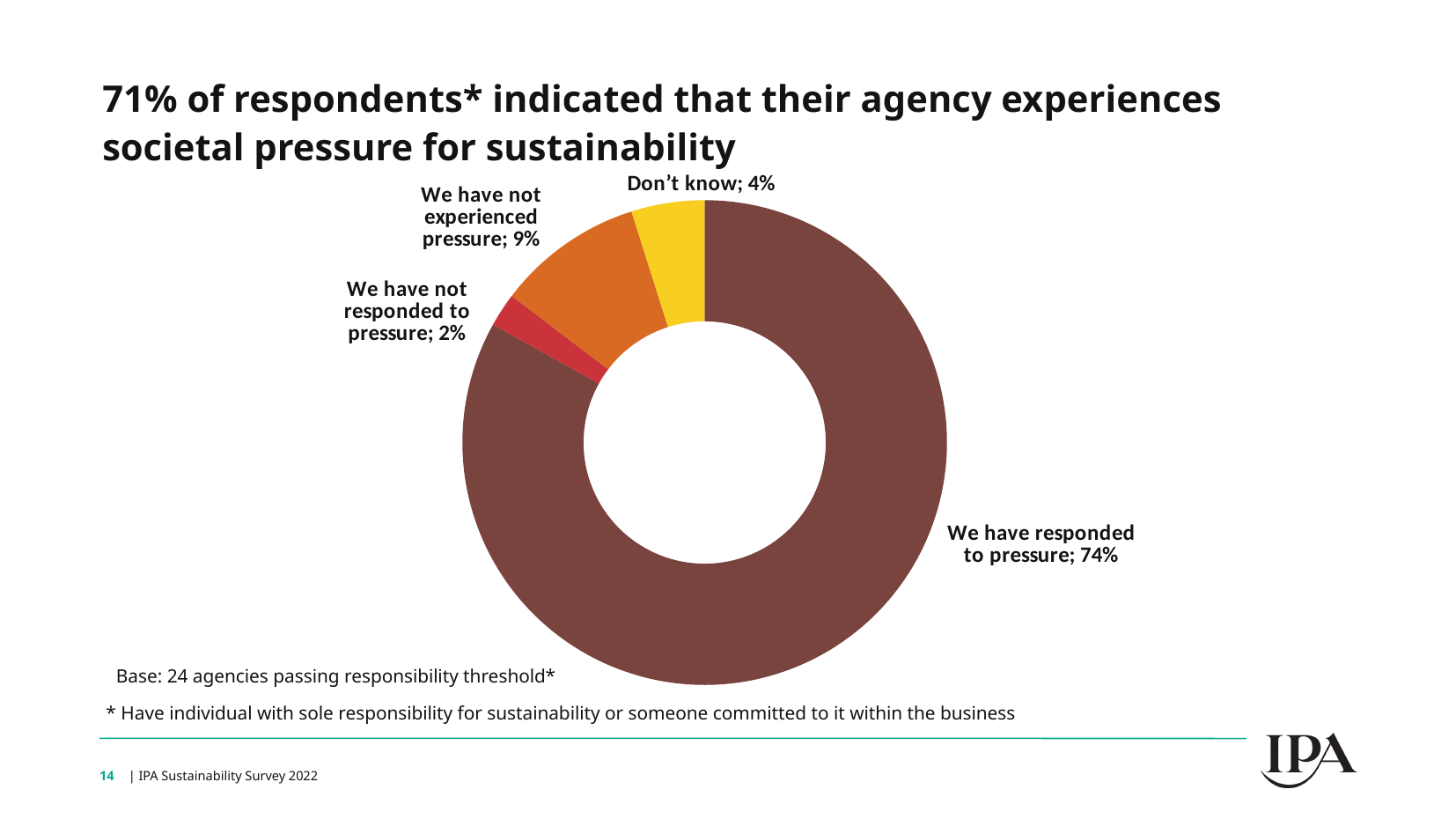
What percentage of respondents said "We have not responded to pressure"? 2% What colour is the "Don't know" slice? Yellow What is the difference in percentage points between "Don't know" and "We have not responded to pressure"? 2 What is the difference in percentage points between "We have responded to pressure" and "We have not experienced pressure"? 65 Which category has the smallest share of the chart? We have not responded to pressure What percentage of respondents answered "Don't know"? 4% How many categories are shown in the chart? 4 What percentage of respondents said "We have responded to pressure"? 74% Which category has the largest share of the chart? We have responded to pressure What percentage of respondents said "We have not experienced pressure"? 9% Which is larger: the share for "Don't know" or the share for "We have not experienced pressure"? We have not experienced pressure What kind of chart is shown on the slide? Pie chart (doughnut)